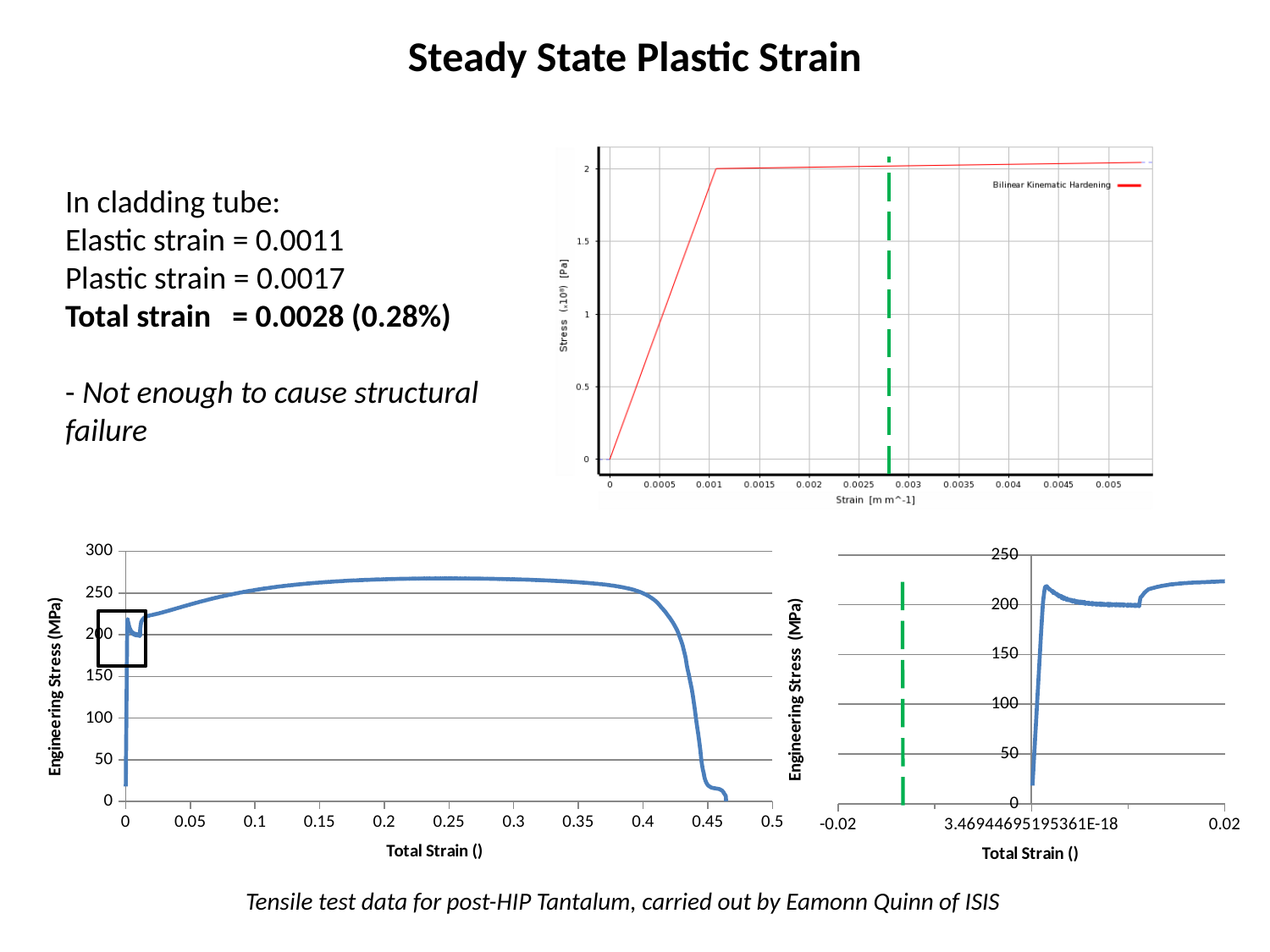
In the bottom-left chart, does the engineering stress rise or fall as total strain goes from 0.4 to 0.45? fall In the top-right chart, does the stress rise or fall as strain goes from 0 to 0.001? rise What is the x-axis title of the bottom-left chart? Total Strain () In the bottom-left chart, is the engineering stress at a total strain of 0.25 greater or less than 250? greater In the top-right chart, is the stress at a strain of 0.002 greater or less than 1.5? greater What is the highest value shown on the y-axis of the bottom-right chart? 250 In the bottom-left chart, does the engineering stress rise or fall as total strain goes from 0.1 to 0.25? rise In the bottom-right chart, is the engineering stress at a total strain of 0.02 greater or less than 200? greater In the top-right chart, what series name does the legend show? Bilinear Kinematic Hardening What kind of chart is the bottom-left chart (Engineering Stress vs Total Strain)? line chart How many series does the legend of the top-right chart list? 1